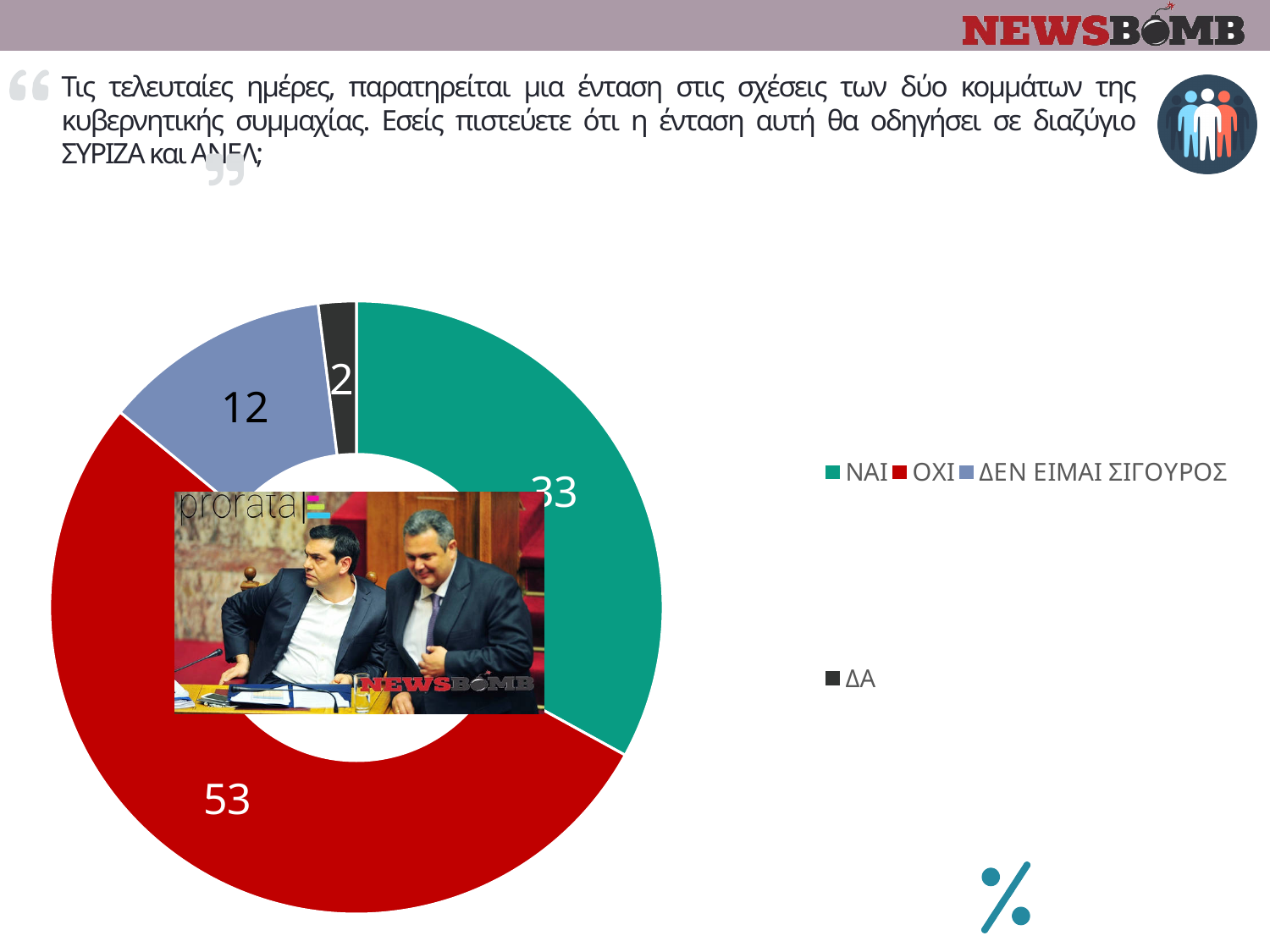
How many categories does the legend list? 4 Which category has the largest slice? ΟΧΙ Which category has the smallest slice? ΔΑ What is the value for ΔΑ? 2 What is the value for ΝΑΙ? 33 What is the difference between the values for ΟΧΙ and ΝΑΙ? 20 Which is larger, the value for ΝΑΙ or the value for ΔΕΝ ΕΙΜΑΙ ΣΙΓΟΥΡΟΣ? ΝΑΙ What colour is the ΔΕΝ ΕΙΜΑΙ ΣΙΓΟΥΡΟΣ slice? Blue What is the value for ΔΕΝ ΕΙΜΑΙ ΣΙΓΟΥΡΟΣ? 12 What is the value for ΟΧΙ? 53 What kind of chart is shown on the slide? Doughnut (pie) chart What colour is the ΟΧΙ slice? Red